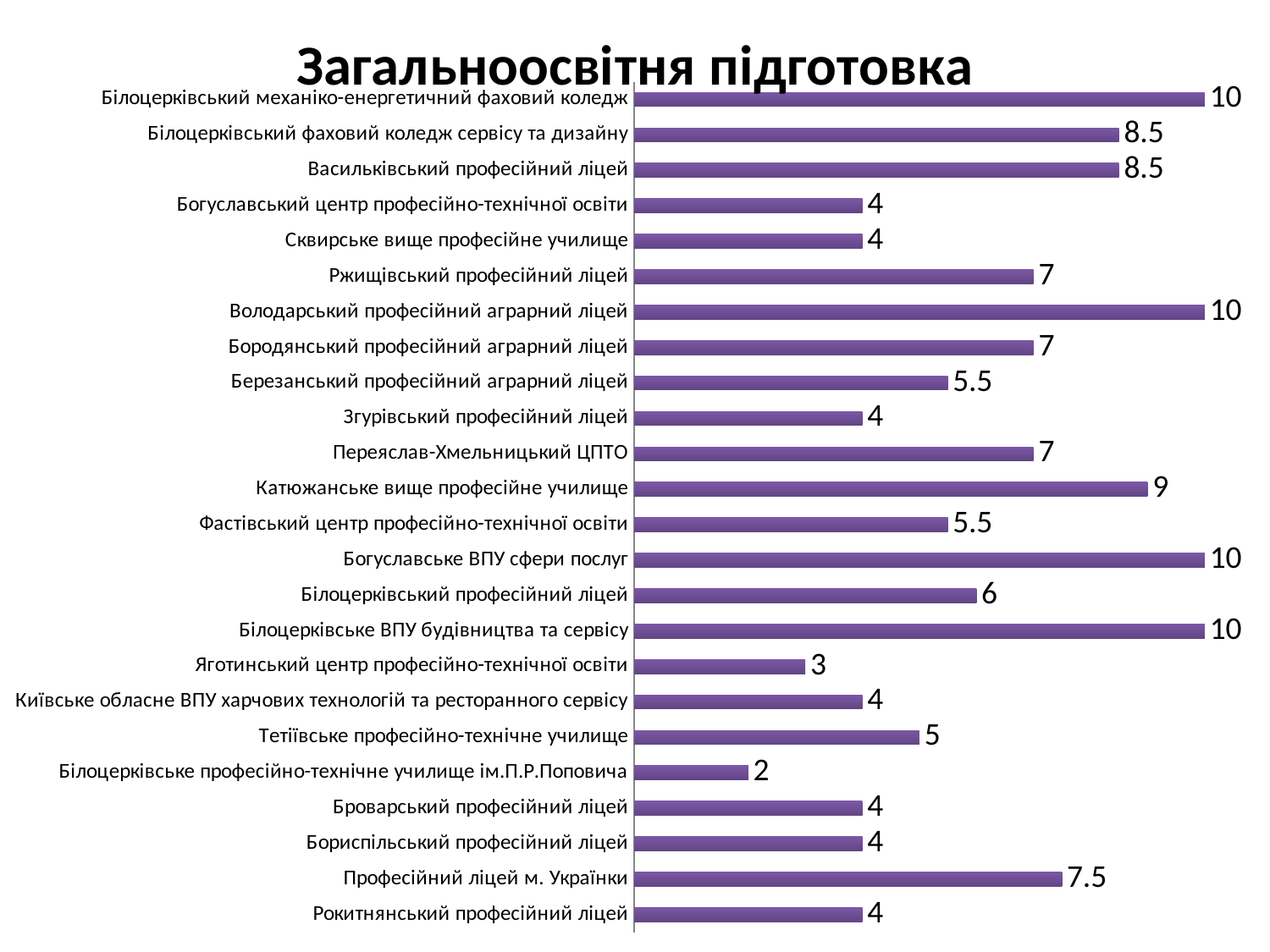
What is the value for Катюжанське вище професійне училище? 9 How many categories are shown in the chart? 24 Which is larger: the value for Васильківський професійний ліцей or the value for Переяслав-Хмельницький ЦПТО? Васильківський професійний ліцей Which is larger: the value for Березанський професійний аграрний ліцей or the value for Бородянський професійний аграрний ліцей? Бородянський професійний аграрний ліцей What is the value for Професійний ліцей м. Українки? 7.5 What is the value for Яготинський центр професійно-технічної освіти? 3 What is the value for Білоцерківський професійний ліцей? 6 What is the difference between the values for Катюжанське вище професійне училище and Тетіївське професійно-технічне училище? 4 What is the difference between the values for Білоцерківський механіко-енергетичний фаховий коледж and Ржищівський професійний ліцей? 3 Which category has the lowest value? Білоцерківське професійно-технічне училище ім.П.Р.Поповича What type of chart is shown on the slide? Bar chart How many categories have a value of 10? 4